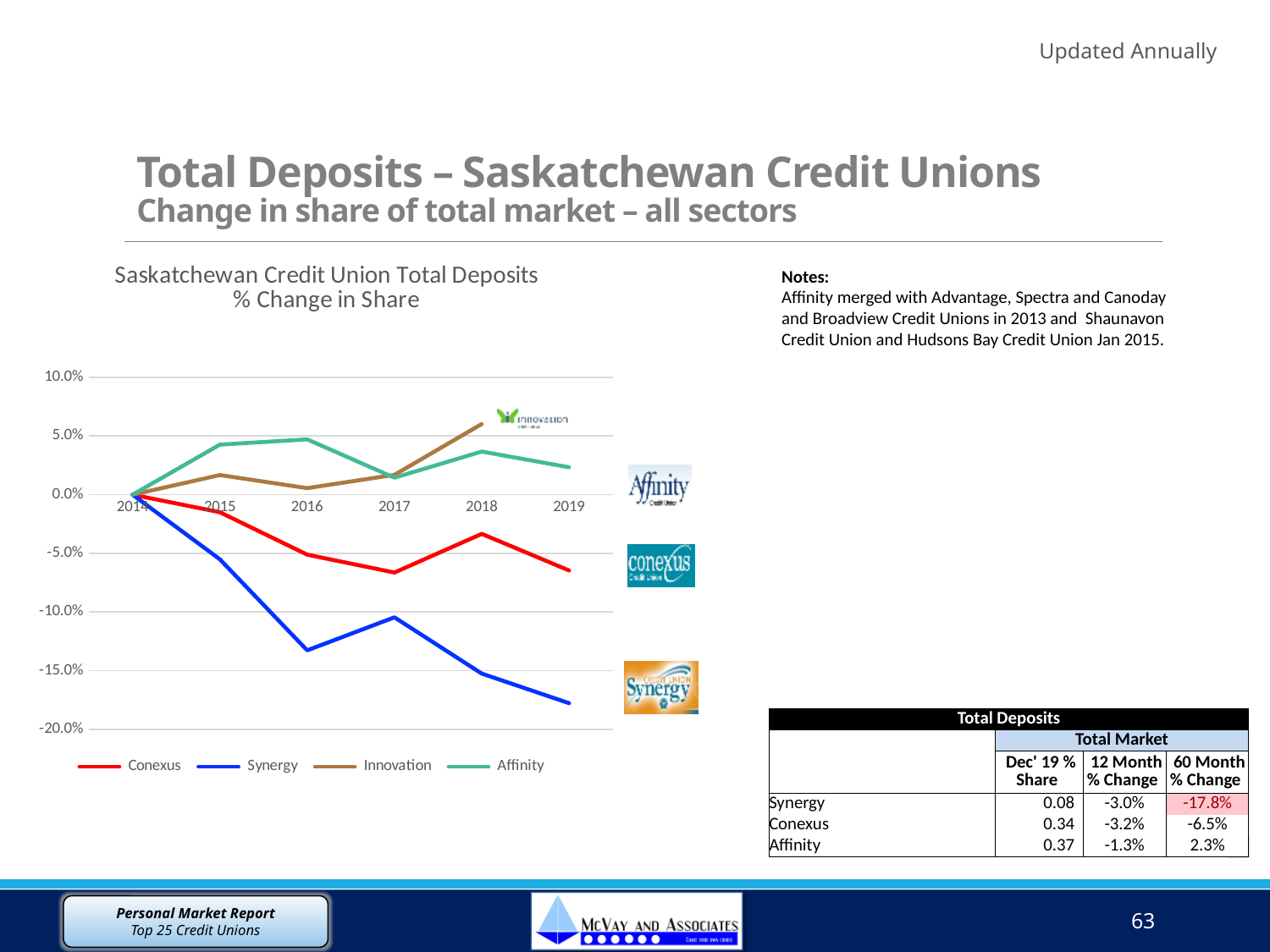
Is the value for Synergy in 2016 greater or less than -10.0%? less Which series has the lowest value in 2019? Synergy Which series has the lowest value in 2016? Synergy Is the value for Synergy in 2019 greater or less than -15.0%? less What kind of chart is shown on the slide? line chart Is the value for Conexus in 2017 greater or less than -5.0%? less How many series does the chart legend list? 4 Which series has the highest value in 2018? Innovation Which is larger in 2019, the value for Affinity or the value for Conexus? Affinity How many years are shown along the x axis of the chart? 6 Does the Synergy line generally rise or fall from 2014 to 2019? fall